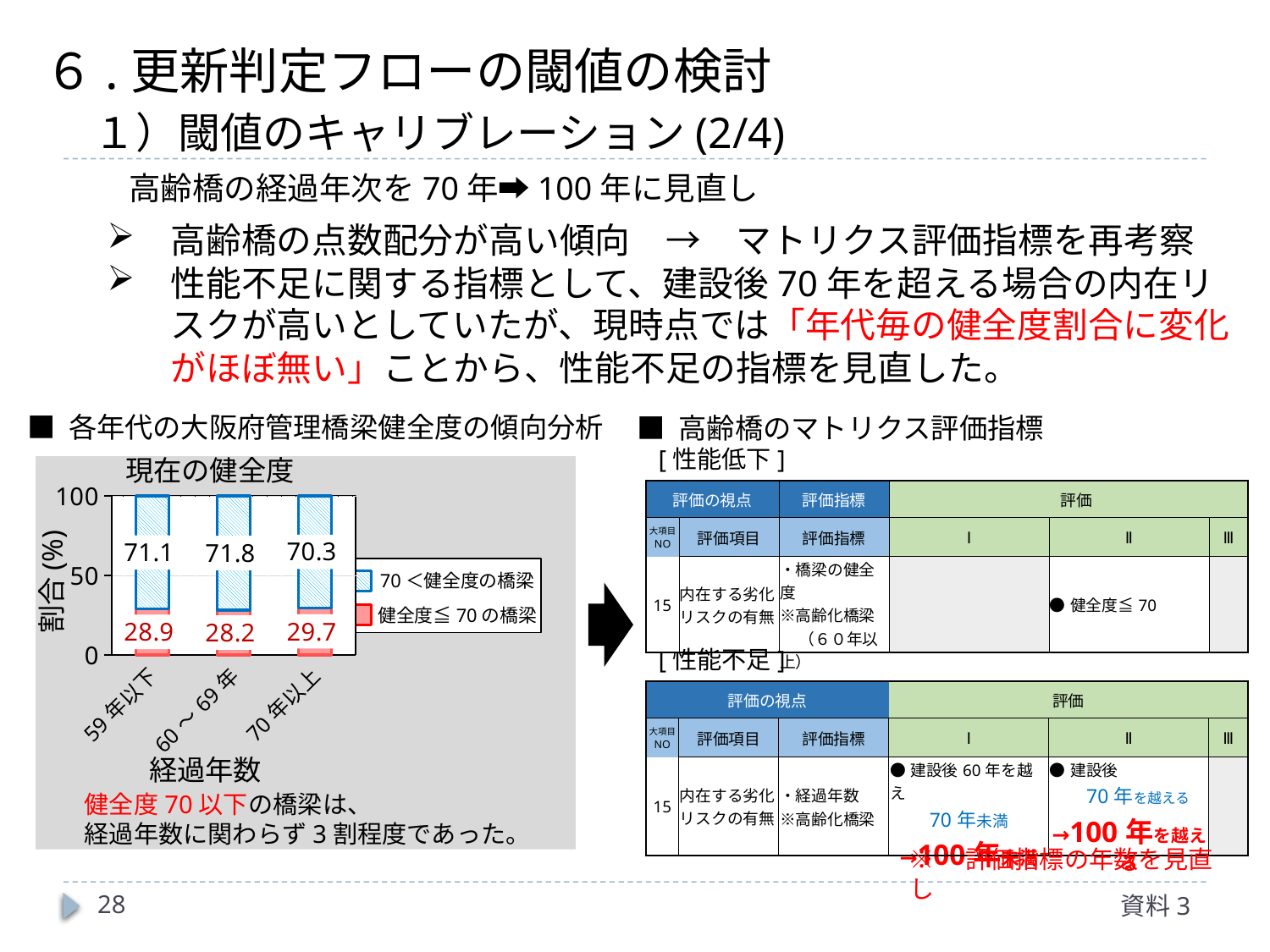
In the 現在の健全度 chart, what is the value of 70＜健全度の橋梁 for 60～69年? 71.8 In the 現在の健全度 chart, which category has the lowest value for 70＜健全度の橋梁? 70年以上 In the 現在の健全度 chart, what is the difference between the 70＜健全度の橋梁 values for 60～69年 and 70年以上? 1.5 In the 現在の健全度 chart, what is the value of 健全度≦70の橋梁 for 59年以下? 28.9 In the 現在の健全度 chart, which is larger for 59年以下: 70＜健全度の橋梁 or 健全度≦70の橋梁? 70＜健全度の橋梁 In the 現在の健全度 chart, which category has the highest value for 健全度≦70の橋梁? 70年以上 How many categories are shown on the x axis of the 現在の健全度 chart? 3 In the 現在の健全度 chart, what is the value of 健全度≦70の橋梁 for 70年以上? 29.7 In the 現在の健全度 chart, what is the total of the stacked bar for 60～69年? 100 How many series does the legend of the 現在の健全度 chart list? 2 What is the label of the y axis of the 現在の健全度 chart? 割合(%) What type of chart is shown under the title 現在の健全度? stacked bar chart